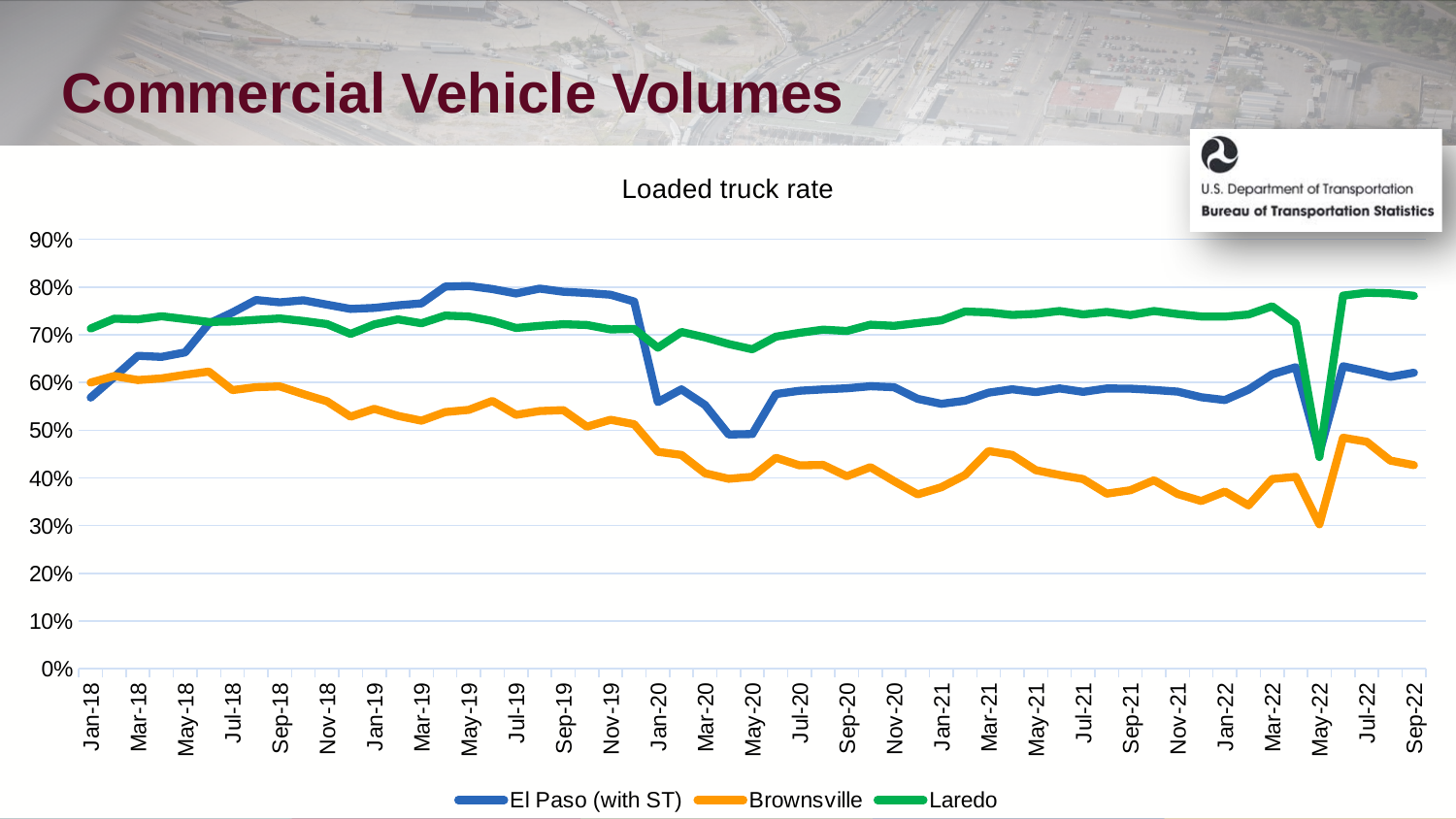
How many series does the legend list? 3 Is the value for Brownsville in Mar-21 greater or less than 50%? less In Jul-19, which is larger: El Paso (with ST) or Laredo? El Paso (with ST) What kind of chart is shown on the slide? line chart Which series is drawn in green? Laredo What is the title of the chart? Loaded truck rate Does the Brownsville line generally rise or fall from Jan-18 to Sep-22? fall Which series has the lowest value in Sep-22? Brownsville Is the value for Brownsville in Sep-22 greater or less than 40%? greater Is the value for El Paso (with ST) in Jan-20 greater or less than 60%? less